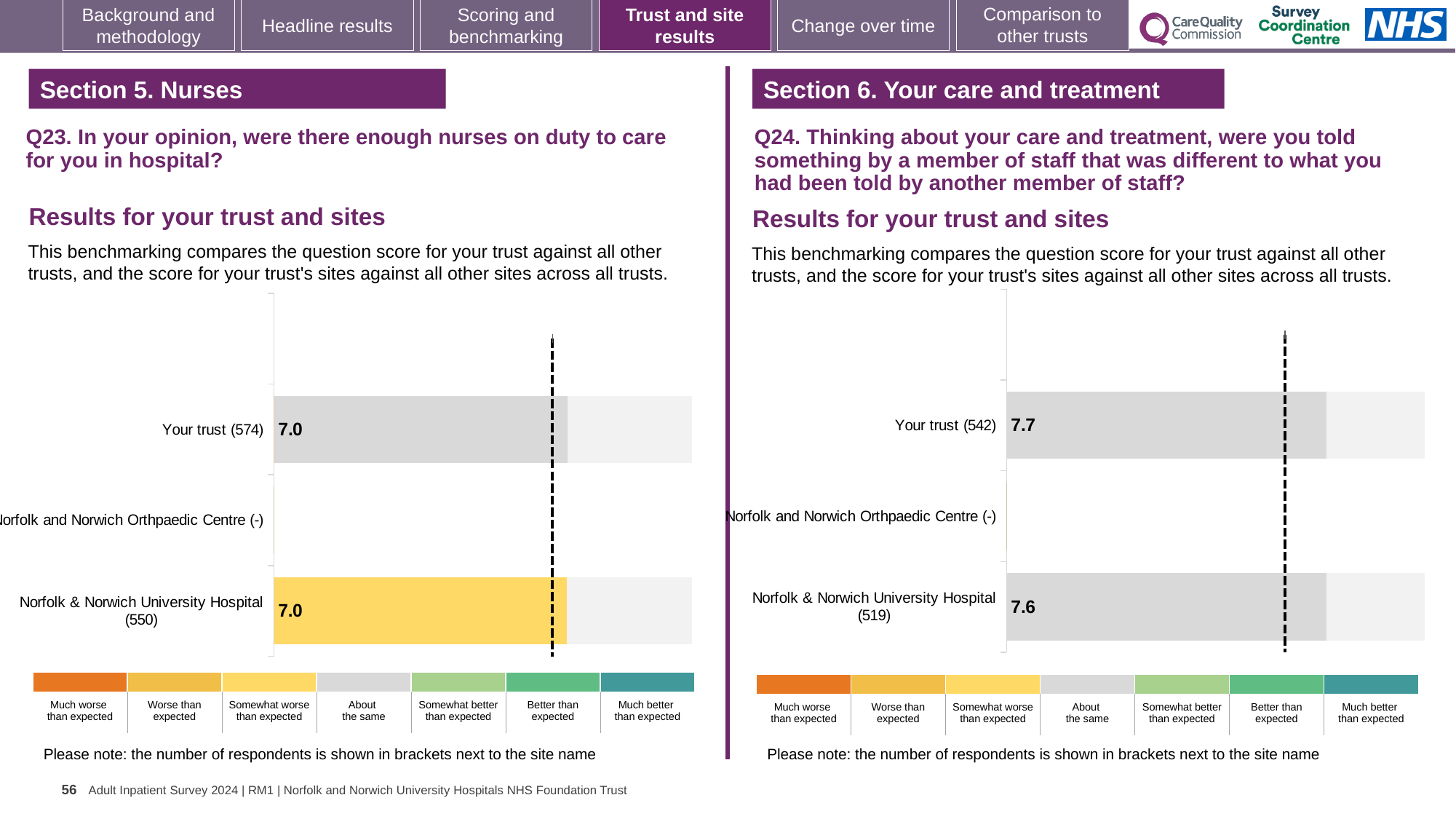
On the Q23 chart (left), which benchmark category does the yellow colour of the Norfolk & Norwich University Hospital bar correspond to in the key? Somewhat worse than expected On the Q23 chart (left), what is the score for Your trust (574)? 7.0 What type of chart is used on the Q23 chart (left)? Bar chart On the Q24 chart (right), what is the difference between the score for Your trust (542) and the score for Norfolk & Norwich University Hospital (519)? 0.1 On the Q24 chart (right), how many site/trust categories are listed on the vertical axis? 3 On the Q24 chart (right), which has the higher score: Your trust (542) or Norfolk & Norwich University Hospital (519)? Your trust (542) On the Q24 chart (right), what is the score for Norfolk & Norwich University Hospital (519)? 7.6 On the Q23 chart (left), what is the score for Norfolk & Norwich University Hospital (550)? 7.0 On the Q24 chart (right), what is the score for Your trust (542)? 7.7 On the Q23 chart (left), how many respondents are shown in brackets for Your trust? 574 On the Q24 chart (right), which benchmark category does the grey colour of the Your trust bar correspond to in the key? About the same On the Q23 chart (left), how many site/trust categories are listed on the vertical axis? 3